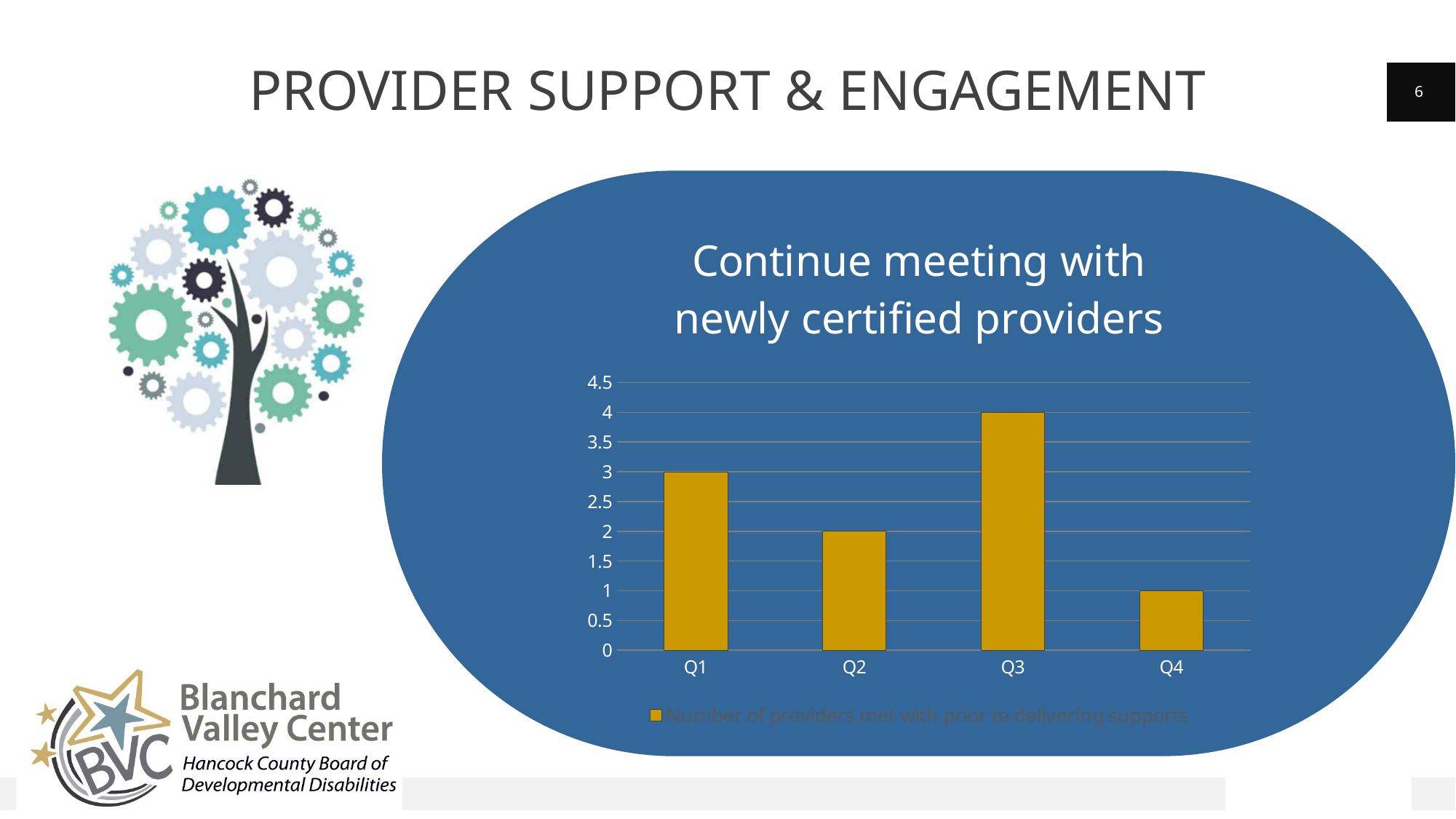
What kind of chart is shown on the slide? Bar chart Which quarter has the highest number of providers met with prior to delivering supports? Q3 What is the legend entry for the series in the chart? Number of providers met with prior to delivering supports How many quarters are shown on the x axis of the chart? 4 How many series does the chart legend list? 1 Which is larger, the value for Q1 or the value for Q2? Q1 What is the value for Q1 in the bar chart? 3 Which quarter has the lowest number of providers met with prior to delivering supports? Q4 What is the value for Q4 in the bar chart? 1 What is the value for Q3 in the bar chart? 4 What is the difference between the values for Q3 and Q4? 3 What is the value for Q2 in the bar chart? 2